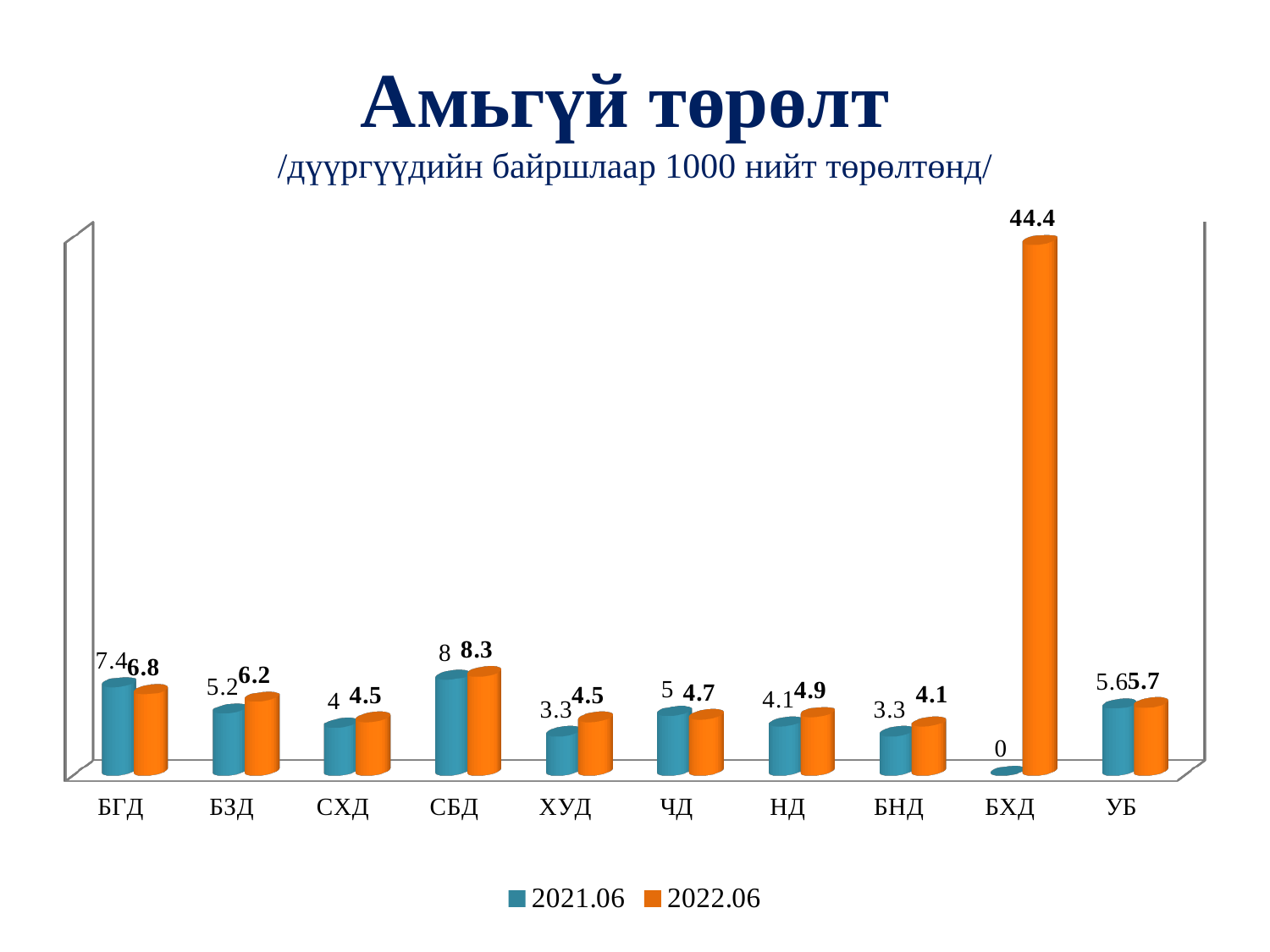
Which is larger for ЧД: the 2021.06 value or the 2022.06 value? 2021.06 Which category has the lowest value in the 2021.06 series? БХД What is the value for СБД in the 2021.06 series? 8 What kind of chart is shown on the slide? Bar chart How many series does the legend list? 2 Which category has the highest value in the 2022.06 series? БХД How many categories are shown on the x axis? 10 What is the value for БХД in the 2021.06 series? 0 What is the value for БХД in the 2022.06 series? 44.4 What is the value for ХУД in the 2022.06 series? 4.5 What are the two series names listed in the legend? 2021.06 and 2022.06 What is the difference between the 2022.06 and 2021.06 values for БЗД? 1